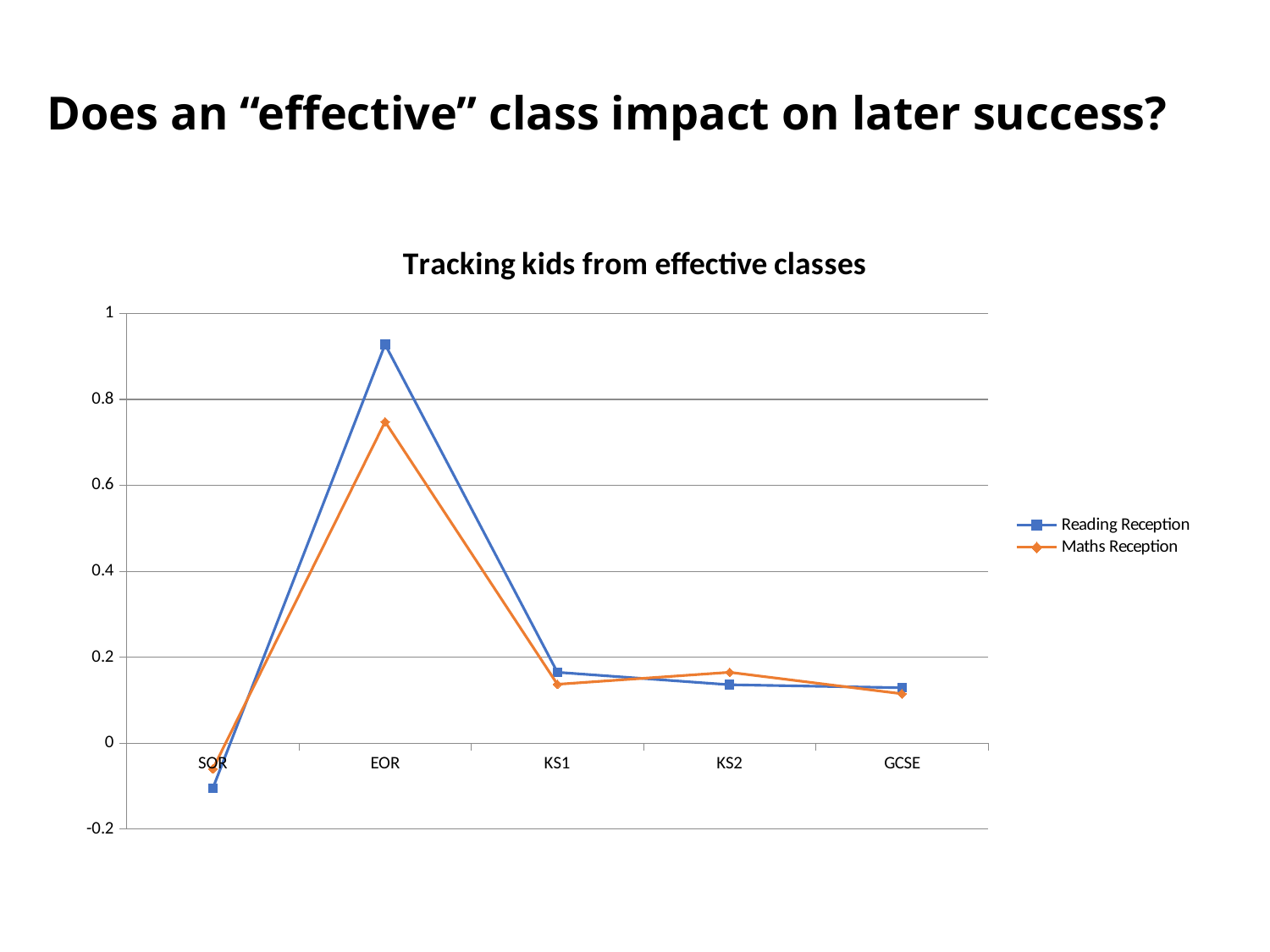
At which category does the Reading Reception series reach its highest value? EOR How many categories are shown on the x axis? 5 How many series does the legend list? 2 At which category does the Maths Reception series reach its lowest value? SOR What kind of chart is shown on the slide? line chart At EOR, which series has the higher value, Reading Reception or Maths Reception? Reading Reception Is the value for Reading Reception at EOR greater or less than 0.8? greater What is the title of the chart? Tracking kids from effective classes From EOR to GCSE, does the Reading Reception series rise or fall overall? fall Is the value for Reading Reception at SOR greater or less than 0? less Is the value for Maths Reception at EOR greater or less than 0.8? less